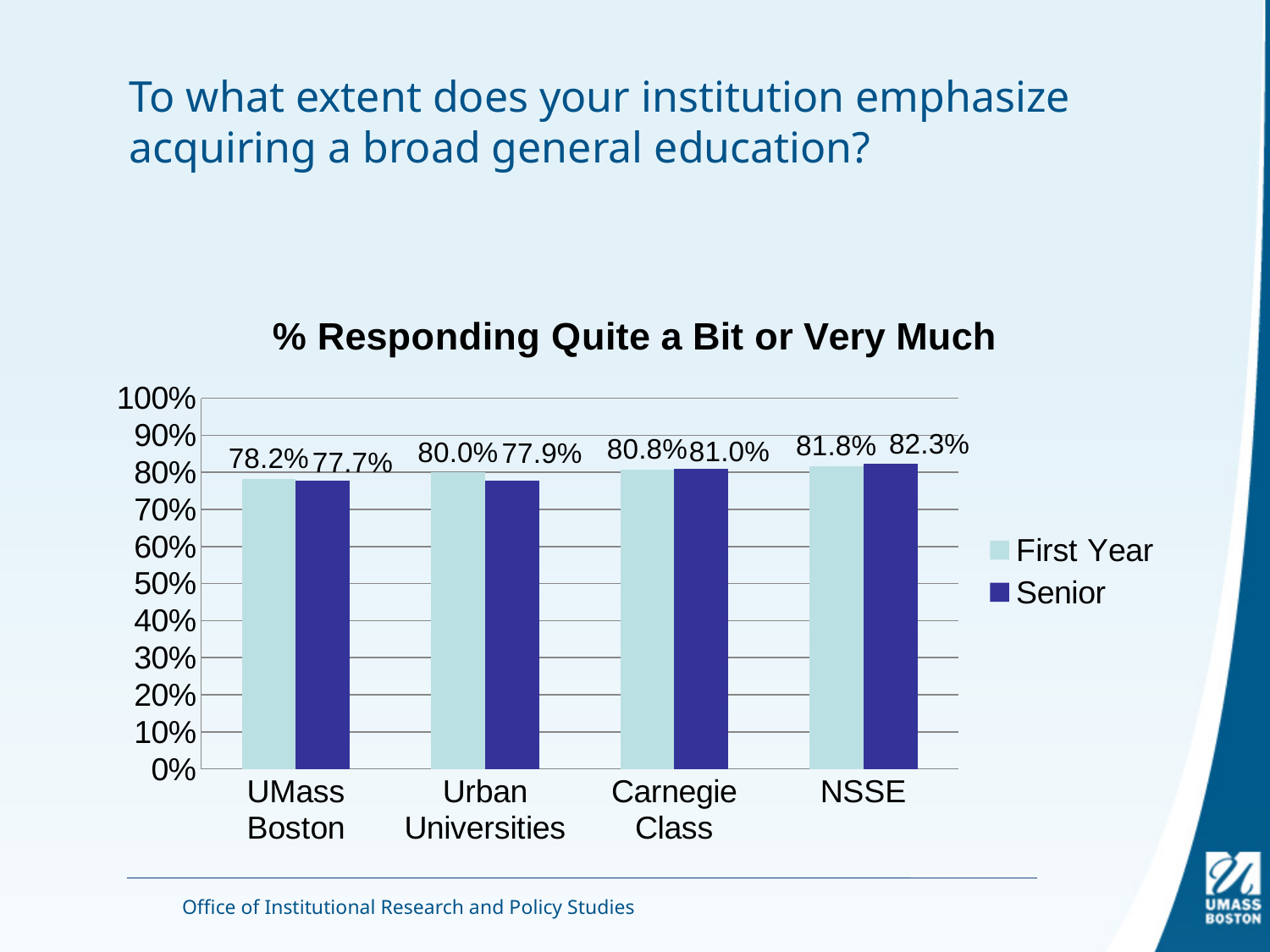
What kind of chart is shown? bar chart What is the First Year value for Carnegie Class? 80.8% What is the Senior value for NSSE? 82.3% What is the difference between the First Year and Senior values for Urban Universities? 2.1% Which category has the lowest First Year value? UMass Boston How many categories are shown on the x axis? 4 Is the First Year value for NSSE greater or less than 80%? greater How many series does the legend list? 2 What is the title of the chart? % Responding Quite a Bit or Very Much Which category has the highest Senior value? NSSE What is the First Year value for UMass Boston? 78.2% What is the Senior value for Urban Universities? 77.9%